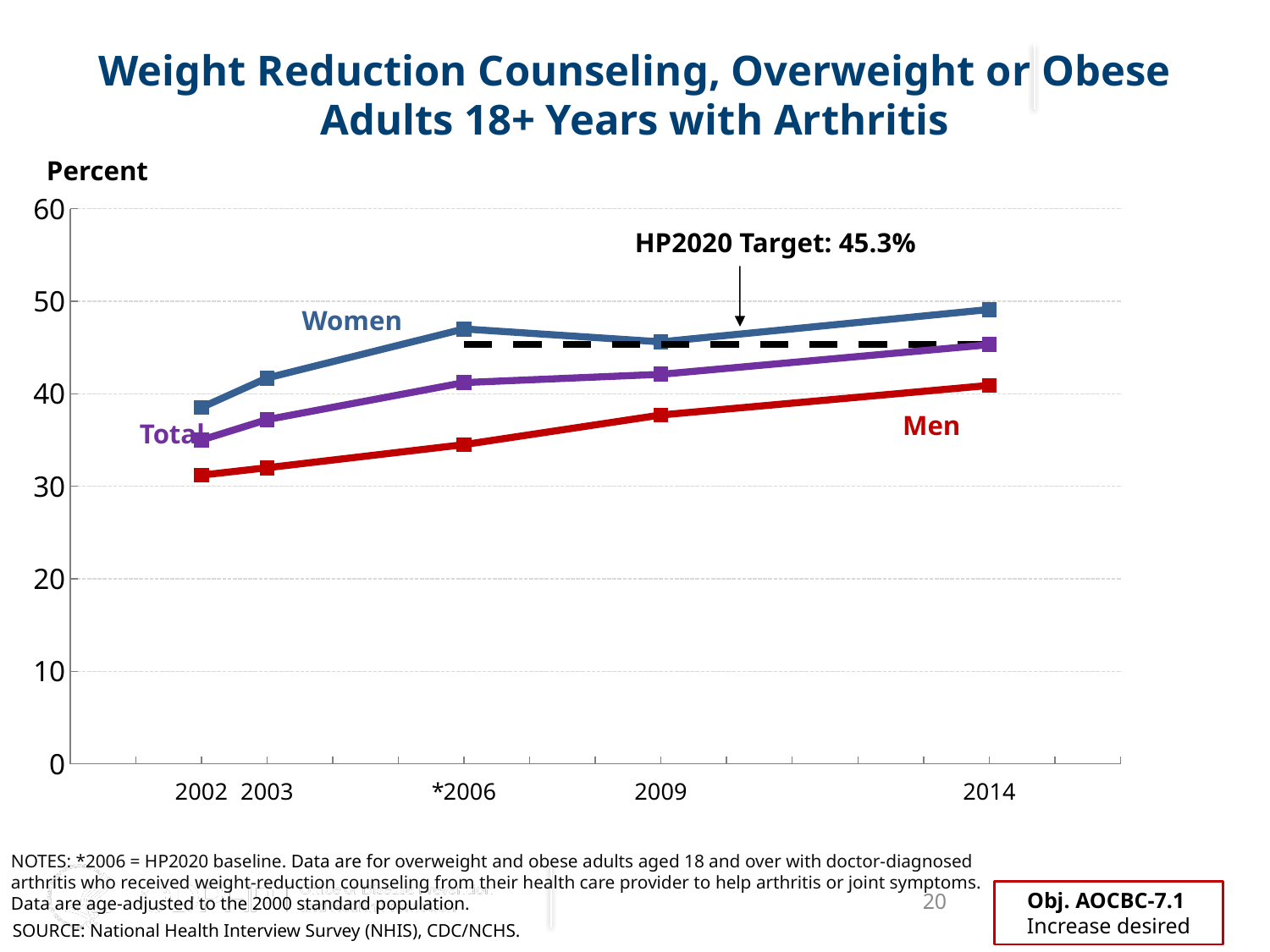
Is the value for Men in 2014 greater or less than 50? less Which group has the lowest value in 2002? Men Is the value for Women in 2014 greater or less than 40? greater How many years are plotted along the x axis? 5 What is the label on the vertical axis? Percent Is the value for Men in 2002 greater or less than 40? less What is the HP2020 Target value shown on the chart? 45.3% Which group has the highest value in 2014? Women How many data series (lines) are plotted, excluding the target line? 3 In 2009, which is larger, the value for Women or the value for Men? Women Do the values for Men rise or fall from 2002 to 2014? Rise What kind of chart is shown on the slide? Line chart